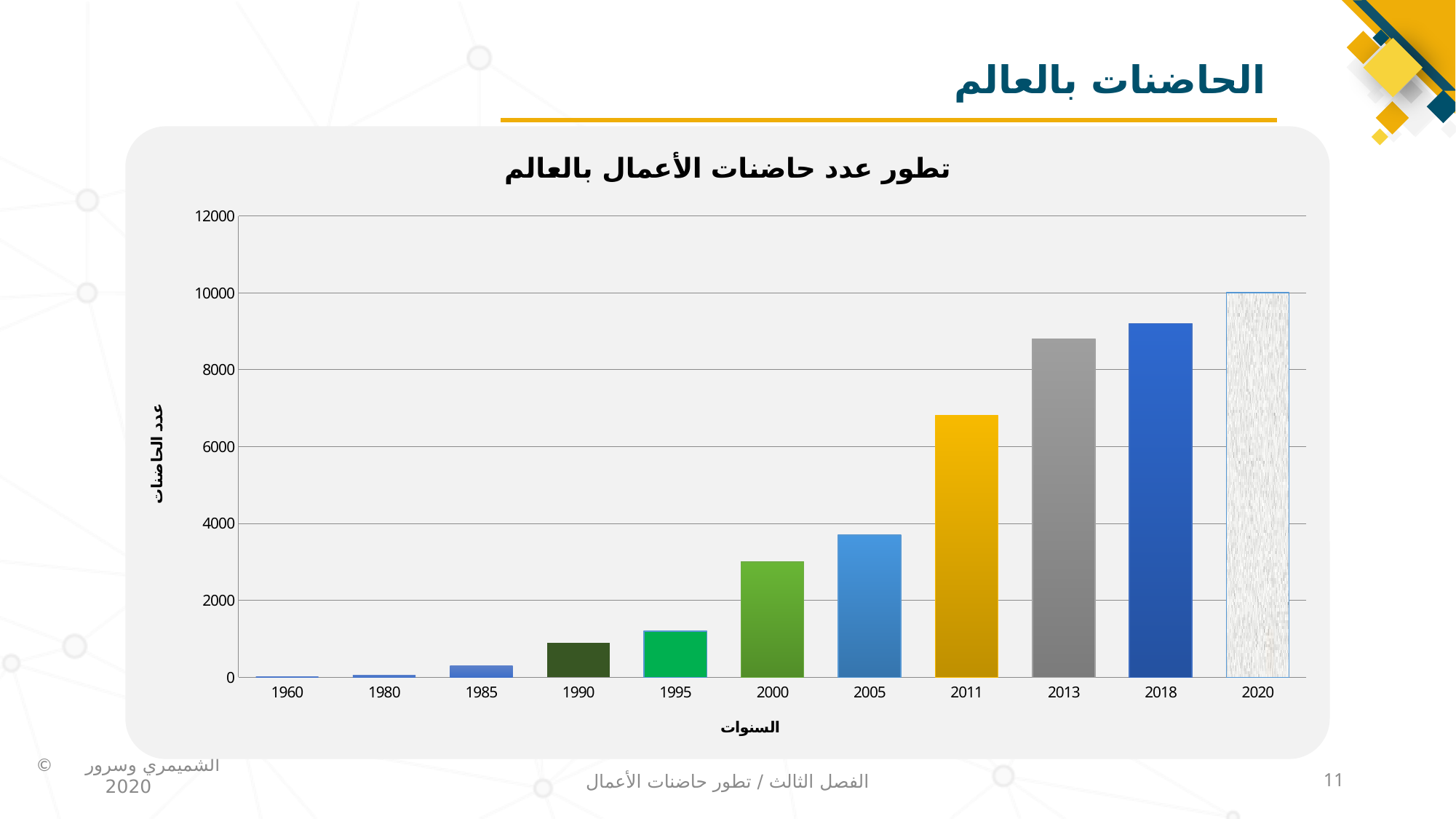
Do the values rise or fall as the years progress along the x axis? rise Is the value for 2011 greater or less than 6000? greater Is the value for 2013 greater or less than 8000? greater Which year has the highest number of incubators in the chart? 2020 Which year has the lowest number of incubators in the chart? 1960 What kind of chart is shown on the slide? bar chart Is the value for 1995 greater or less than 2000? less Which year has a larger value, 2000 or 2018? 2018 What is the label of the x axis of the chart? السنوات What is the title of the chart? تطور عدد حاضنات الأعمال بالعالم How many years are shown on the x axis of the chart? 11